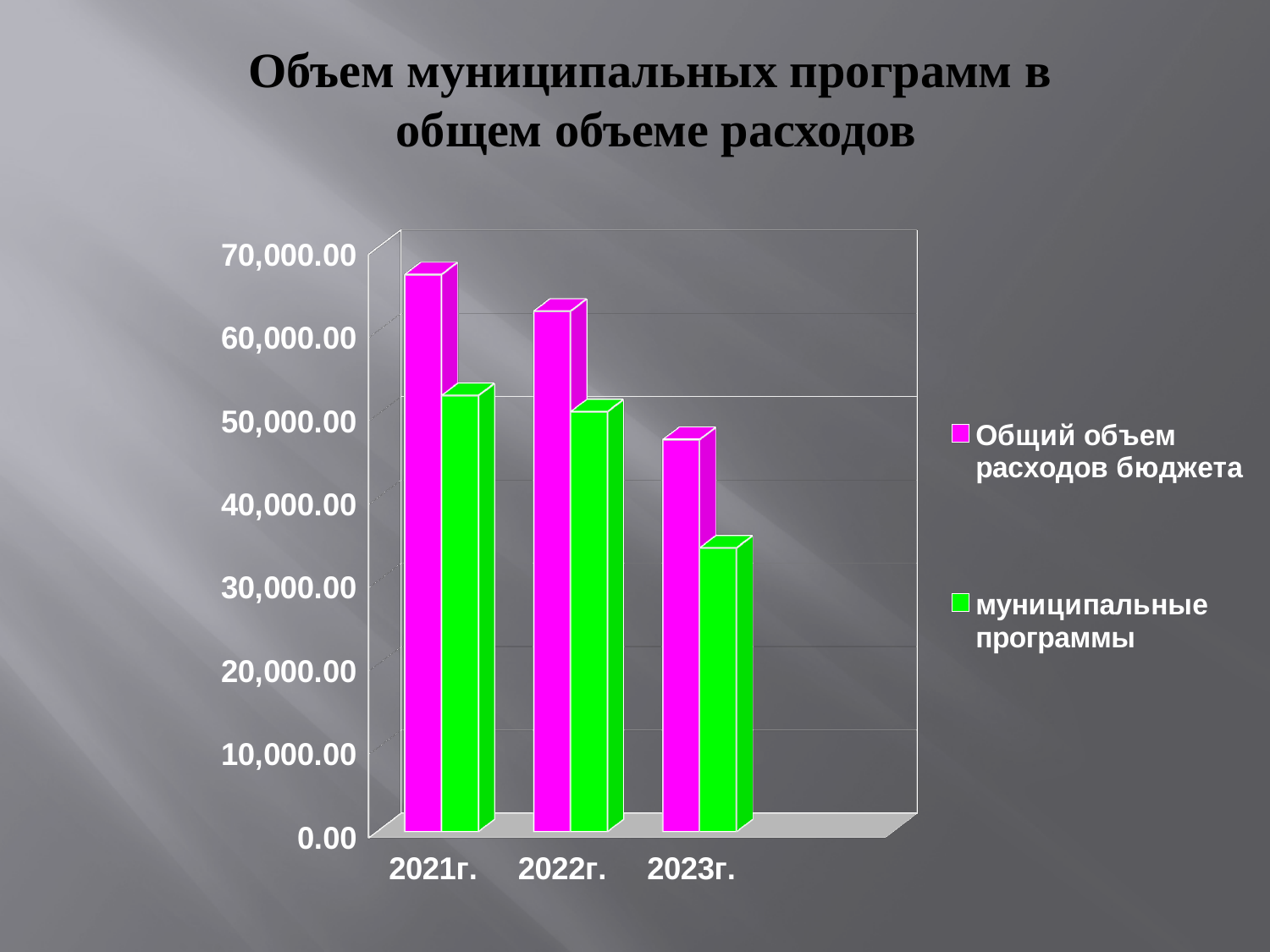
Is the value for "муниципальные программы" in 2022г. greater or less than 40,000.00? greater How many series does the legend list? 2 How many years (categories) are shown on the x axis? 3 What kind of chart is shown on the slide? bar chart Do the values for "Общий объем расходов бюджета" rise or fall from 2021г. to 2023г.? fall Which colour represents "муниципальные программы" in the legend? green In which year is the value for "Общий объем расходов бюджета" the highest? 2021г. Is the value for "Общий объем расходов бюджета" in 2021г. greater or less than 60,000.00? greater Is the value for "муниципальные программы" in 2023г. greater or less than 40,000.00? less In which year is the value for "муниципальные программы" the lowest? 2023г. Which year has the larger value for "муниципальные программы": 2022г. or 2023г.? 2022г. Which year has the larger value for "Общий объем расходов бюджета": 2021г. or 2023г.? 2021г.